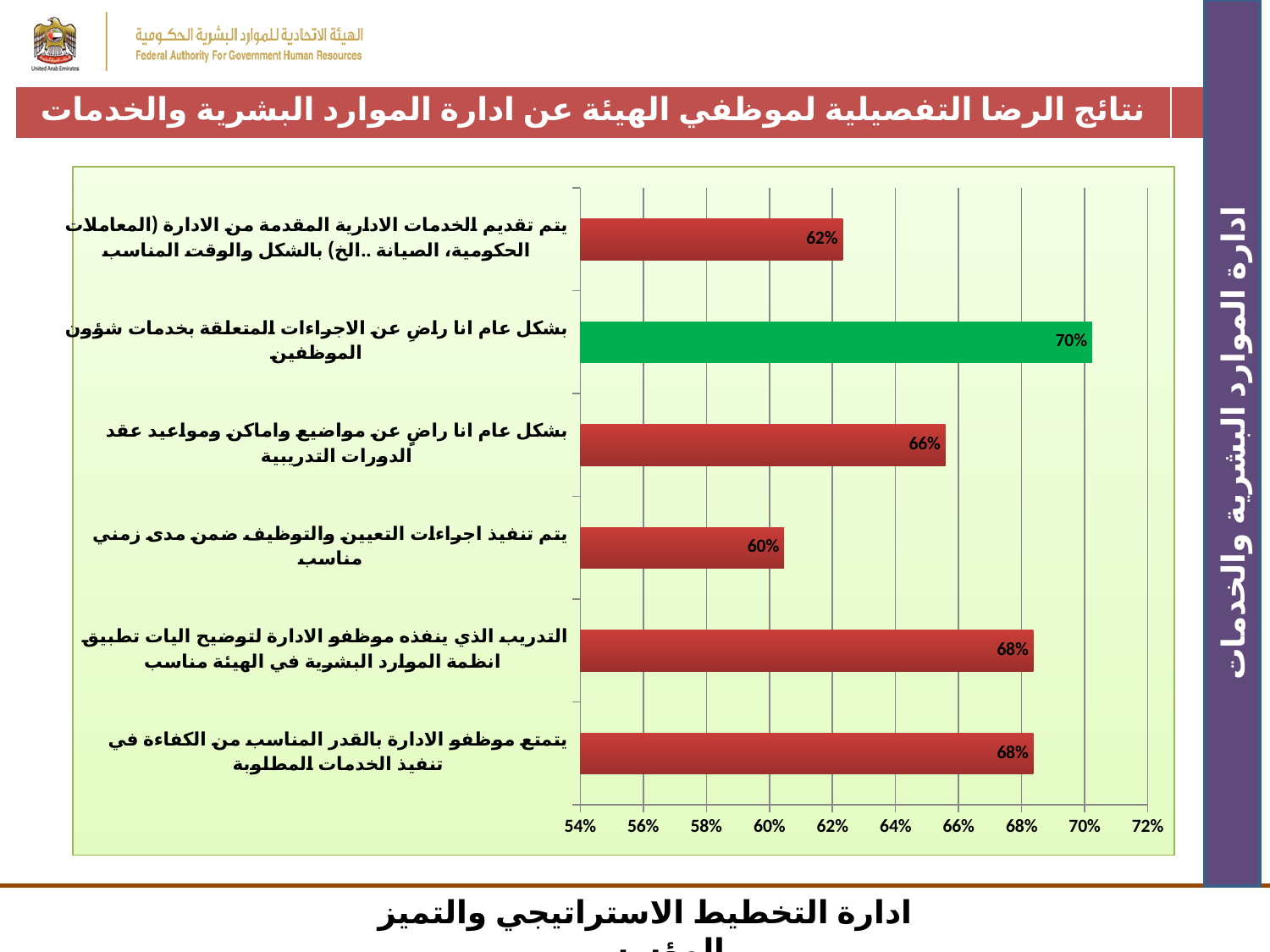
Is the value for "التدريب الذي ينفذه موظفو الادارة لتوضيح اليات تطبيق انظمة الموارد البشرية في الهيئة مناسب" greater or less than 64%? greater What type of chart is shown on the slide? Bar chart What is the value for the top bar, "يتم تقديم الخدمات الادارية المقدمة من الادارة (المعاملات الحكومية، الصيانة ..الخ) بالشكل والوقت المناسب"? 62% What is the value for "بشكل عام انا راضٍ عن مواضيع واماكن ومواعيد عقد الدورات التدريبية"? 66% What is the difference between the highest value (70%) and the lowest value (60%) in the chart? 10 percentage points What is the value for "بشكل عام انا راضٍ عن الاجراءات المتعلقة بخدمات شؤون الموظفين"? 70% Which bar in the chart is coloured green rather than red? بشكل عام انا راضٍ عن الاجراءات المتعلقة بخدمات شؤون الموظفين What is the value for "يتم تنفيذ اجراءات التعيين والتوظيف ضمن مدى زمني مناسب"? 60% Which statement has the highest satisfaction value? بشكل عام انا راضٍ عن الاجراءات المتعلقة بخدمات شؤون الموظفين How many categories (statements) are plotted in the chart? 6 Which statement has the lowest satisfaction value? يتم تنفيذ اجراءات التعيين والتوظيف ضمن مدى زمني مناسب Which is larger: the value for "بشكل عام انا راضٍ عن مواضيع واماكن ومواعيد عقد الدورات التدريبية" or the value for "يتم تقديم الخدمات الادارية المقدمة من الادارة ... بالشكل والوقت المناسب"? بشكل عام انا راضٍ عن مواضيع واماكن ومواعيد عقد الدورات التدريبية